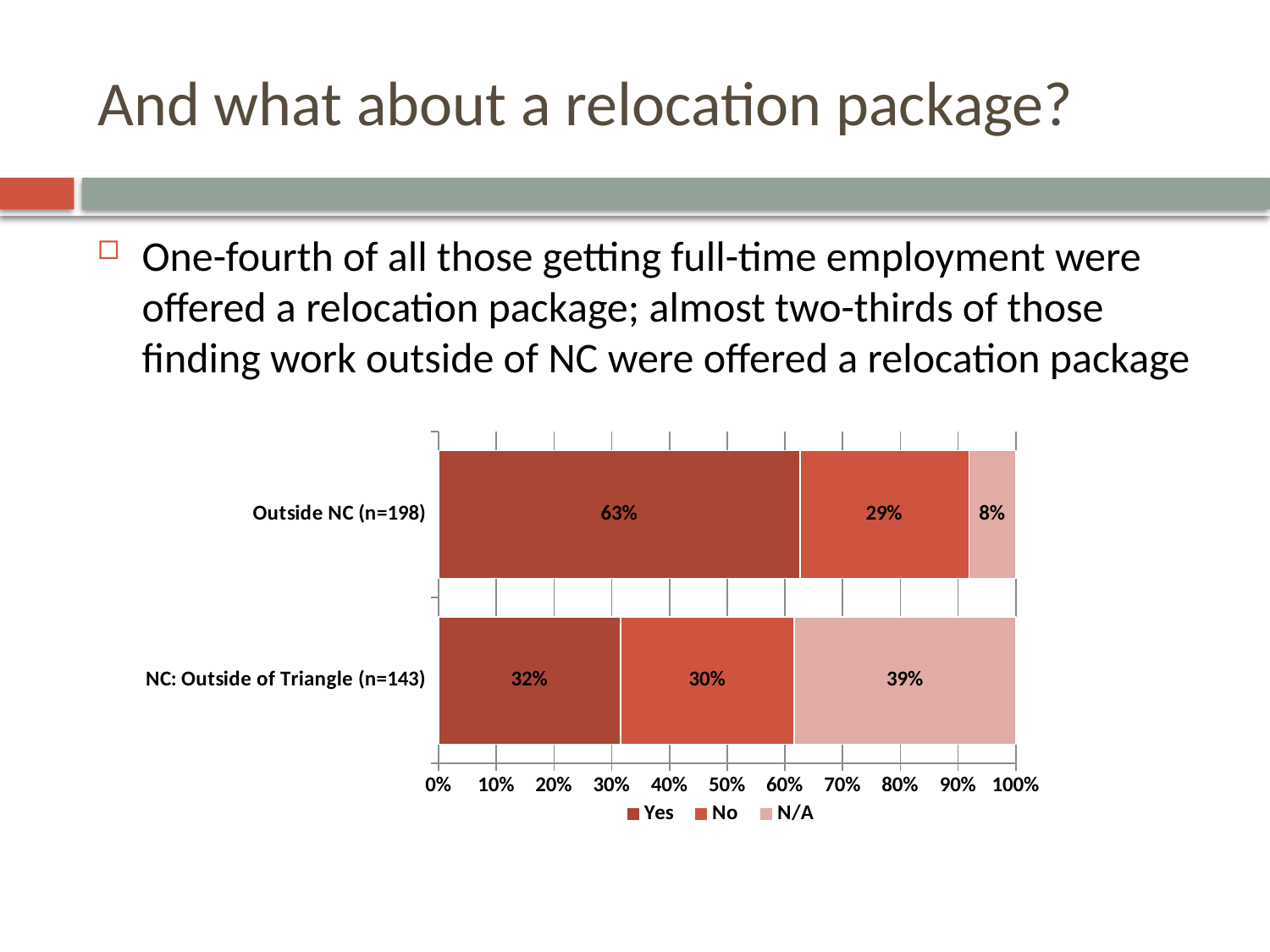
How many categories are shown on the chart? 2 Which category has the lower N/A percentage? Outside NC (n=198) What is the No value for the Outside NC (n=198) category? 29% How many series does the legend list? 3 What are the three legend entries on the chart? Yes, No, N/A What kind of chart is shown on the slide? Stacked bar chart Which category has the higher Yes percentage? Outside NC (n=198) What is the Yes value for the NC: Outside of Triangle (n=143) category? 32% What percentage of the NC: Outside of Triangle (n=143) group answered N/A? 39% What is the difference between the Yes percentages for Outside NC (n=198) and NC: Outside of Triangle (n=143)? 31% Is the N/A value larger for Outside NC (n=198) or for NC: Outside of Triangle (n=143)? NC: Outside of Triangle (n=143) What percentage of the Outside NC (n=198) group answered Yes? 63%